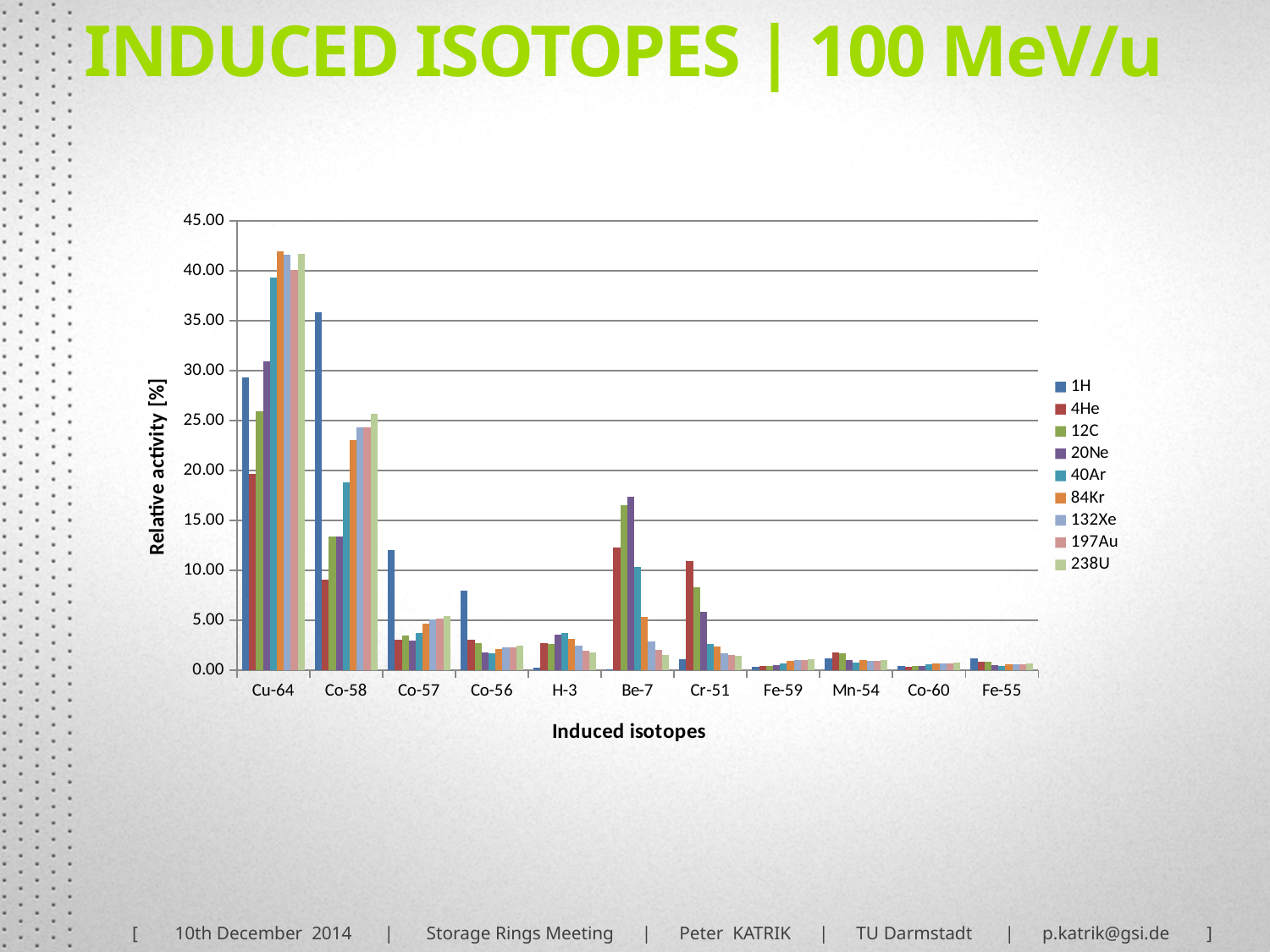
Is the value for 1H at Cu-64 greater or less than 25.00? greater Is the value for 1H at Co-57 greater or less than 10.00? greater How many induced isotopes are listed along the x axis? 11 Is the value for 84Kr at Cu-64 greater or less than 40.00? greater At Co-58, which series has the highest bar? 1H What kind of chart is shown on the slide? bar chart What is the title of the y axis? Relative activity [%] How many series does the legend list? 9 For the 1H series, which isotope has the highest relative activity? Co-58 At Be-7, which is larger: the 20Ne bar or the 1H bar? 20Ne At Cr-51, which is larger: the 4He bar or the 12C bar? 4He